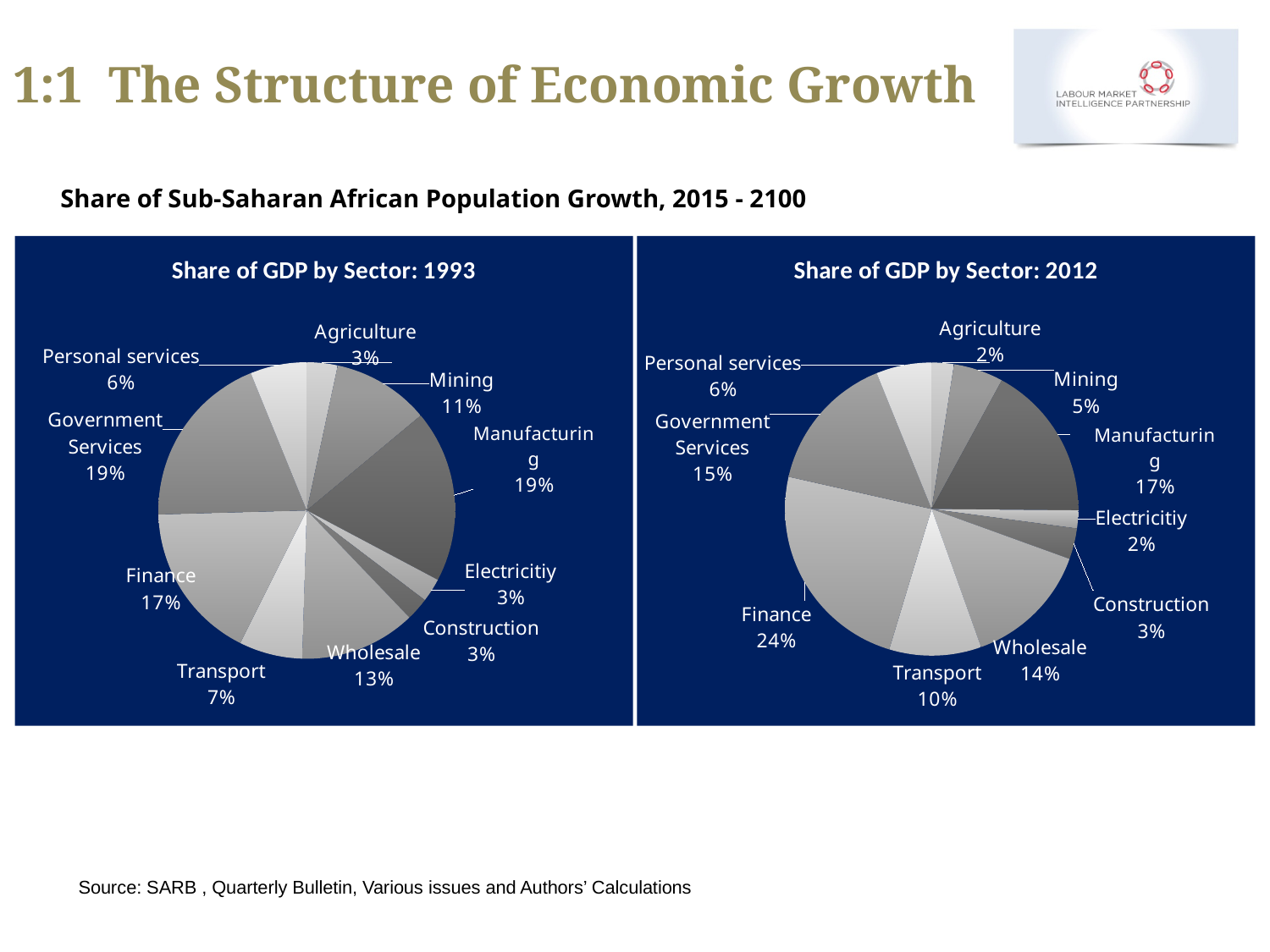
In the 'Share of GDP by Sector: 1993' chart, which is larger, the Finance share or the Wholesale share? Finance In the 'Share of GDP by Sector: 2012' chart, which sector has the largest share? Finance What kind of chart is 'Share of GDP by Sector: 1993'? Pie chart What is the title of the chart on the right side of the slide? Share of GDP by Sector: 2012 In the 'Share of GDP by Sector: 1993' chart, what share does Wholesale have? 13% What is the difference between the Finance share in the 2012 chart and the Finance share in the 1993 chart? 7% In the 'Share of GDP by Sector: 1993' chart, what is the difference between the Manufacturing share and the Transport share? 12% In the 'Share of GDP by Sector: 2012' chart, what share does Finance have? 24% In the 'Share of GDP by Sector: 1993' chart, what share does Mining have? 11% In the 'Share of GDP by Sector: 2012' chart, what share does Government Services have? 15% How many sectors are shown in the 'Share of GDP by Sector: 2012' chart? 10 Which chart shows a larger share for Mining, the 1993 chart or the 2012 chart? 1993